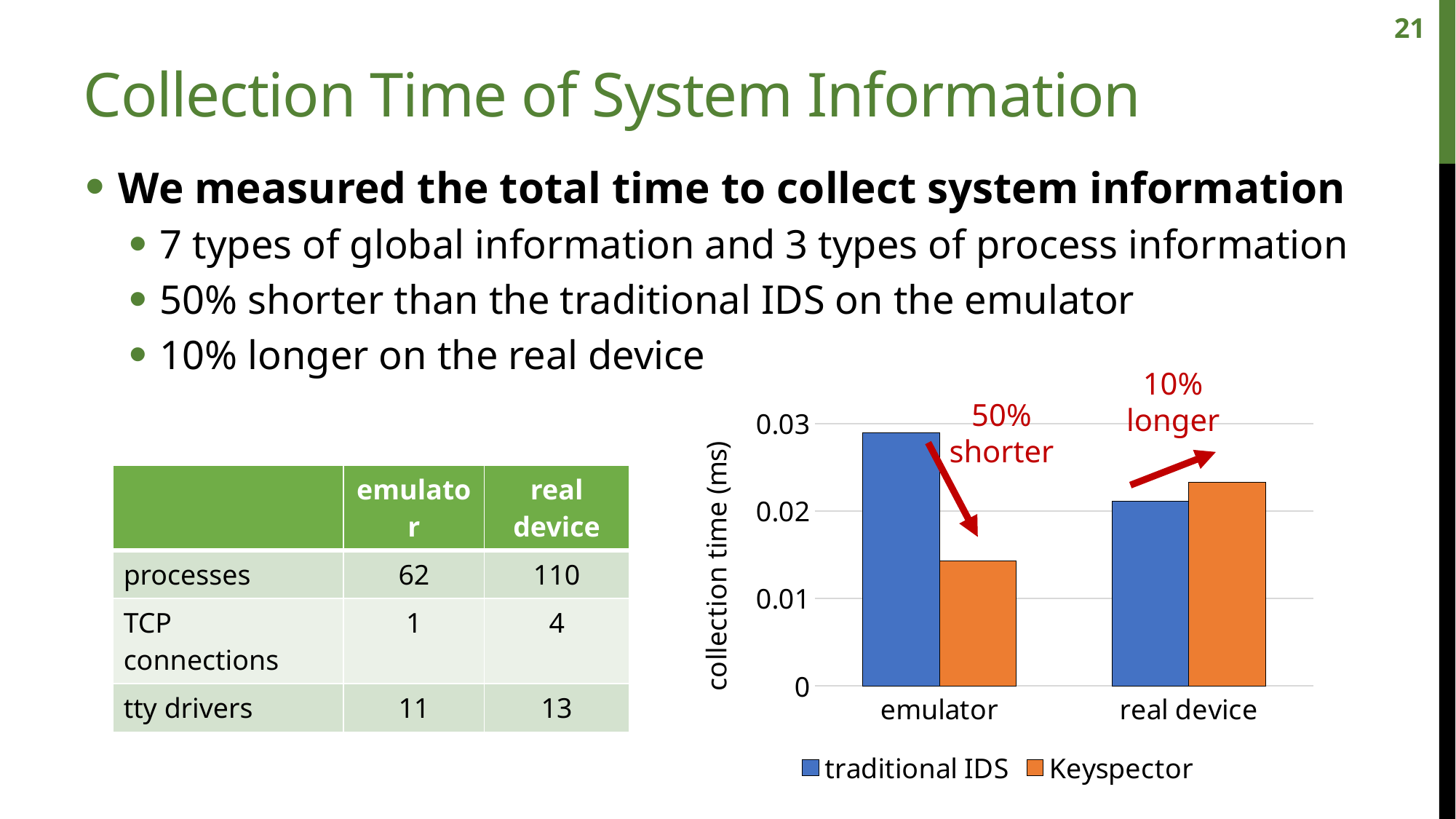
Is the collection time for Keyspector on the emulator greater or less than 0.02? less How many series does the chart's legend list? 2 Which bar in the chart is the highest? traditional IDS on the emulator Which series has the taller bar for the emulator category? traditional IDS How many categories are shown on the x axis of the chart? 2 What kind of chart is shown on the slide? bar chart Is the collection time for traditional IDS on the emulator greater or less than 0.02? greater Is the collection time for Keyspector on the real device greater or less than 0.02? greater Which bar in the chart is the lowest? Keyspector on the emulator What is the label of the chart's y axis? collection time (ms) What annotation is written above the real device bars in the chart? 10% longer Which series has the taller bar for the real device category? Keyspector